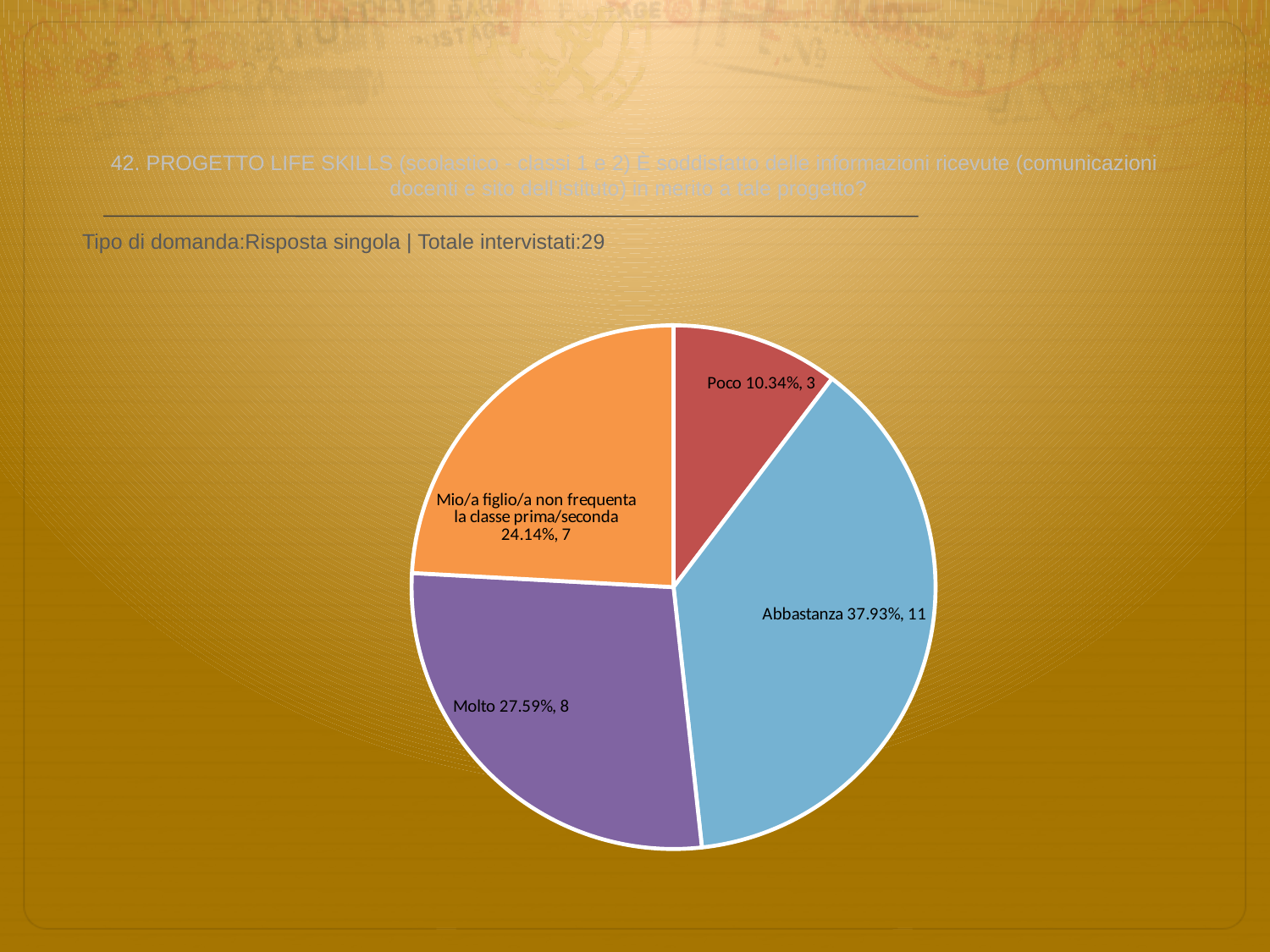
Which response has the largest slice of the pie? Abbastanza What is the total number of respondents across all slices? 29 What is the difference in count between Abbastanza and Molto? 3 Which response has the smallest slice of the pie? Poco How many respondents answered Molto? 8 What kind of chart is shown on the slide? pie chart What percentage share does the Poco slice have? 10.34% How many slices does the pie chart have? 4 How many respondents answered 'Mio/a figlio/a non frequenta la classe prima/seconda'? 7 Which has more respondents, Molto or Poco? Molto What percentage share does the Abbastanza slice have? 37.93% What colour is the Abbastanza slice? light blue